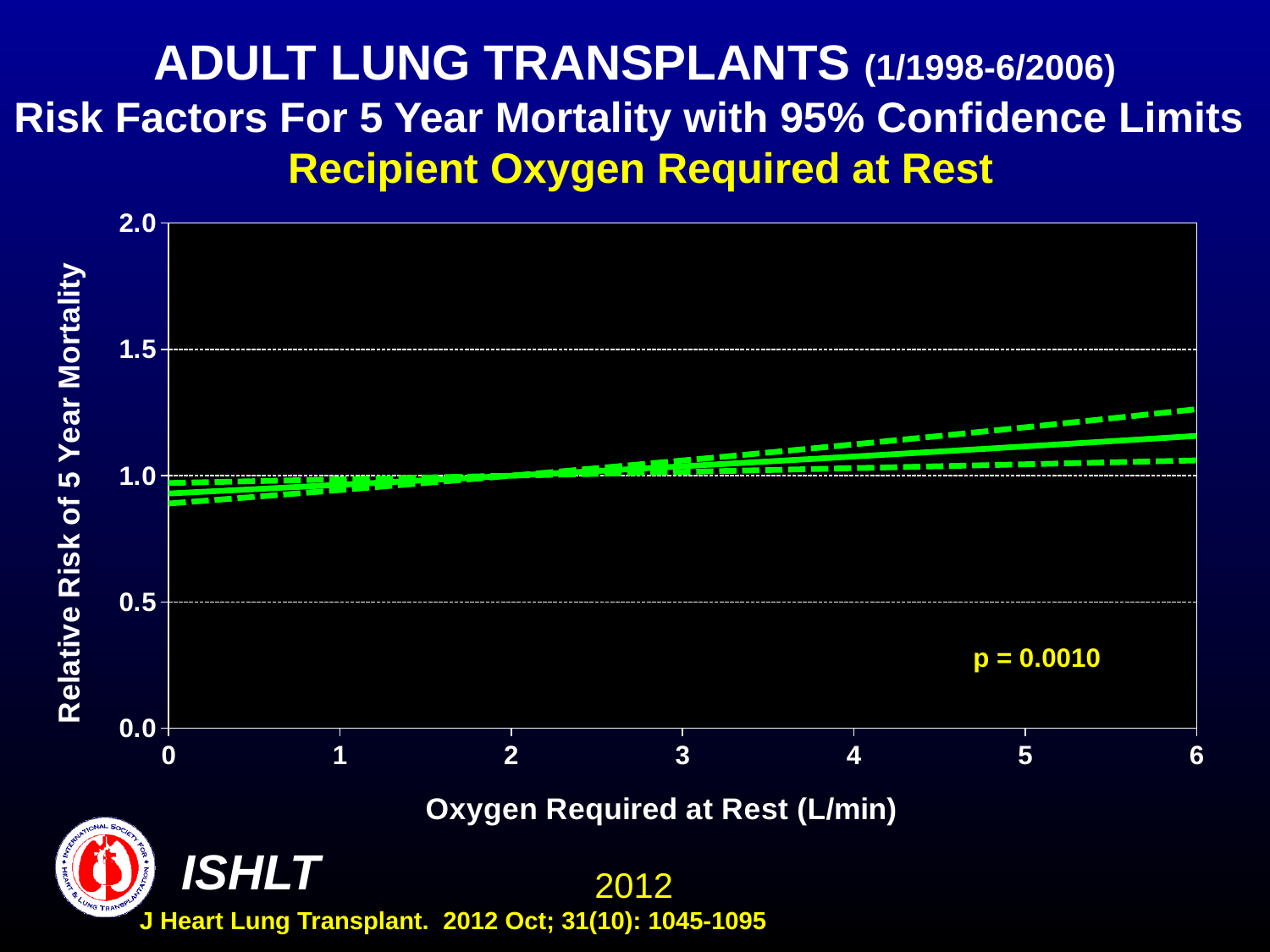
Does the relative risk of 5 year mortality rise or fall as oxygen required at rest increases from 0 to 6 L/min? rise What is the highest value shown on the x axis? 6 What is the label of the x axis? Oxygen Required at Rest (L/min) Is the relative risk shown by the solid line at 3 L/min greater or less than 1.5? less Is the relative risk shown by the solid line at 6 L/min greater or less than 1.5? less What is the highest value shown on the y axis? 2.0 Is the upper dashed confidence limit at 6 L/min greater or less than 1.5? less What kind of chart is shown on the slide? line chart How many lines are plotted on the chart (solid and dashed)? 3 What p-value is printed on the chart? p = 0.0010